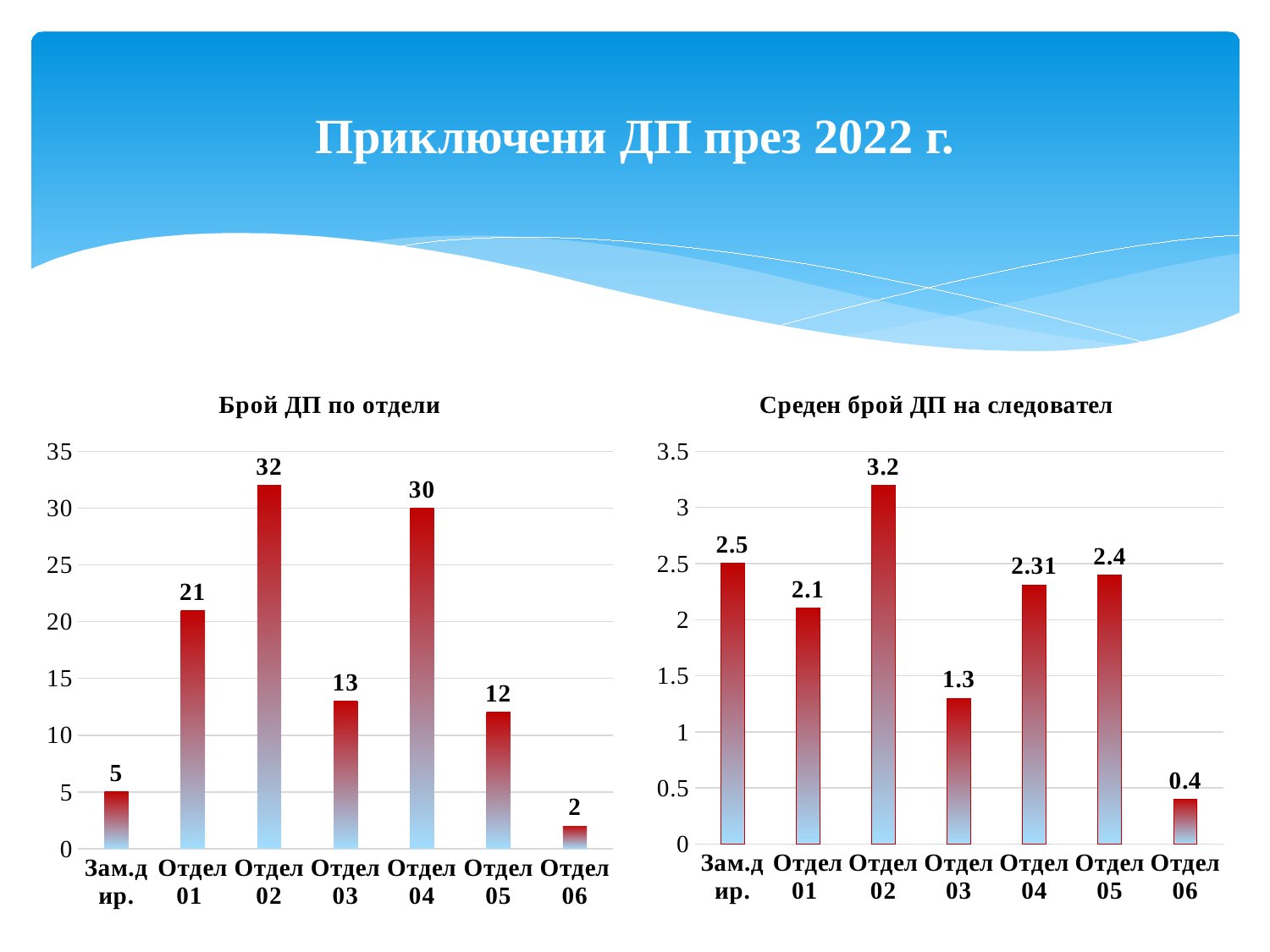
In the chart titled "Среден брой ДП на следовател", which is larger, the value for Зам.дир. or the value for Отдел 05? Зам.дир. In the chart titled "Брой ДП по отдели", how many categories are shown on the x axis? 7 In the chart titled "Брой ДП по отдели", what is the value for Отдел 02? 32 In the chart titled "Брой ДП по отдели", what is the difference between the values for Отдел 02 and Отдел 04? 2 In the chart titled "Среден брой ДП на следовател", which category has the highest value? Отдел 02 In the chart titled "Среден брой ДП на следовател", what is the value for Отдел 06? 0.4 What is the title of the slide? Приключени ДП през 2022 г. In the chart titled "Брой ДП по отдели", what is the value for Зам.дир.? 5 In the chart titled "Среден брой ДП на следовател", what is the value for Отдел 04? 2.31 In the chart titled "Брой ДП по отдели", which category has the lowest value? Отдел 06 What kind of chart is the chart titled "Среден брой ДП на следовател"? bar chart In the chart titled "Брой ДП по отдели", which is larger, the value for Отдел 01 or the value for Отдел 03? Отдел 01